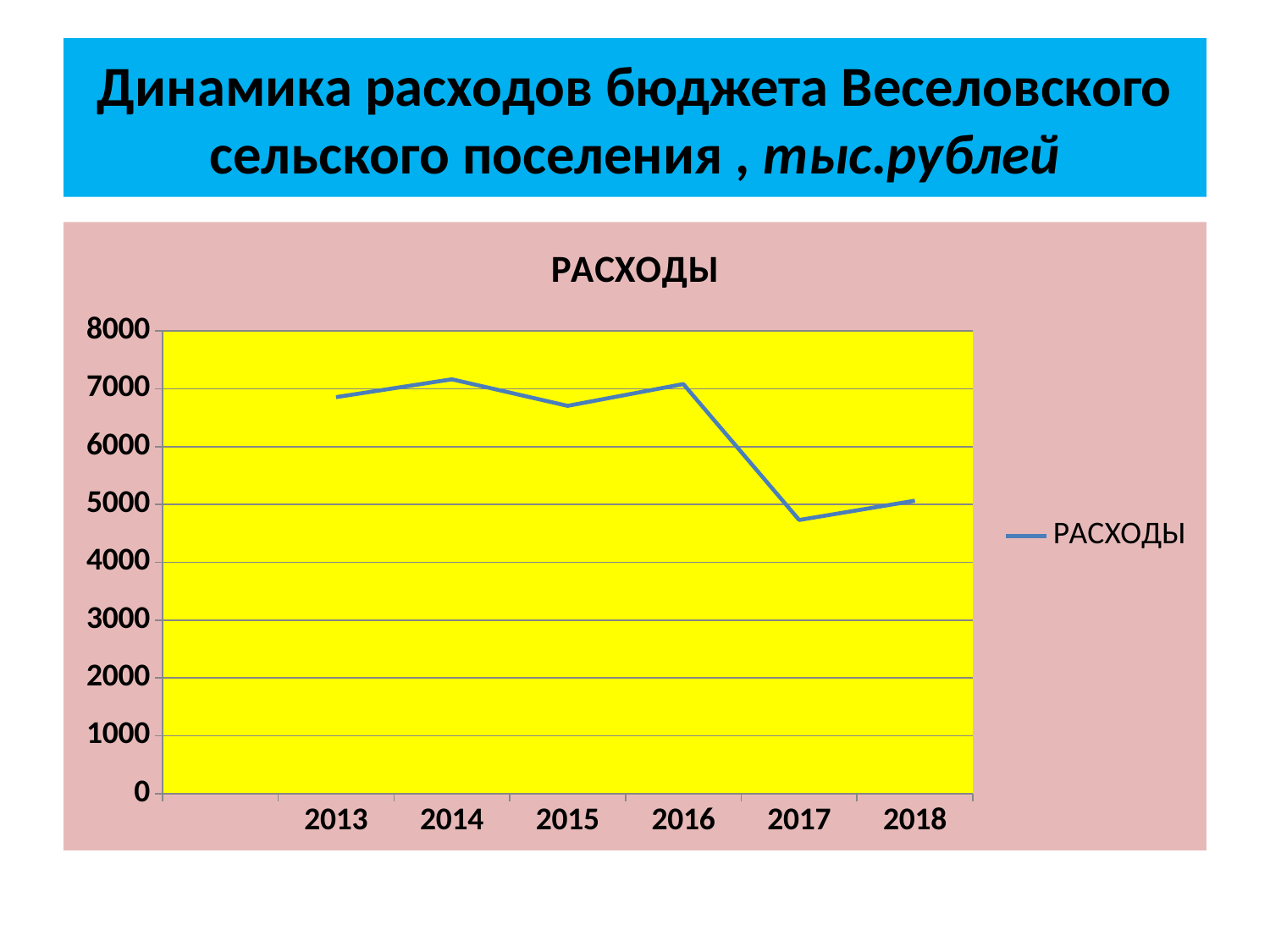
What is the title of the chart? РАСХОДЫ How many years are plotted on the x axis? 6 Which is larger, the value for 2016 or the value for 2018? 2016 How many series does the legend list? 1 Do the values rise or fall from 2016 to 2017? fall Is the value for 2018 greater or less than 6000? less Which is larger, the value for 2013 or the value for 2017? 2013 Is the value for 2017 greater or less than 5000? less What kind of chart is shown on the slide? line chart Which year has the lowest value for РАСХОДЫ? 2017 Is the value for 2015 greater or less than 7000? less